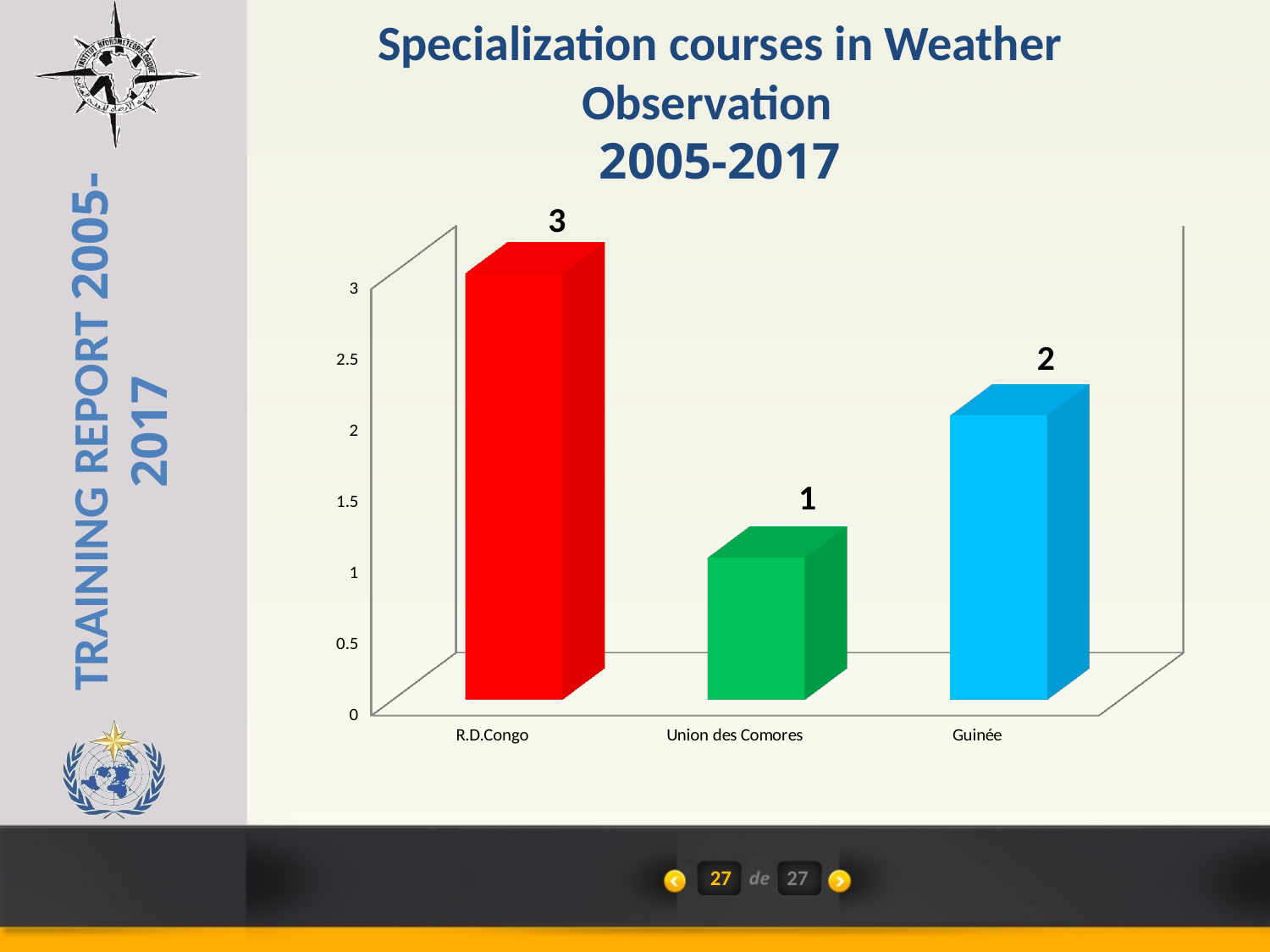
Which country has the highest value? R.D.Congo Is the value for Guinée greater or less than 1.5? greater What is the title of the chart? Specialization courses in Weather Observation 2005-2017 What is the value for Union des Comores? 1 Which country has the lowest value? Union des Comores What is the difference between the values for R.D.Congo and Guinée? 1 What is the value for R.D.Congo? 3 What kind of chart is shown on the slide? bar chart How many countries are shown on the chart? 3 What is the value for Guinée? 2 Which is larger, the value for Guinée or the value for Union des Comores? Guinée What is the difference between the values for R.D.Congo and Union des Comores? 2